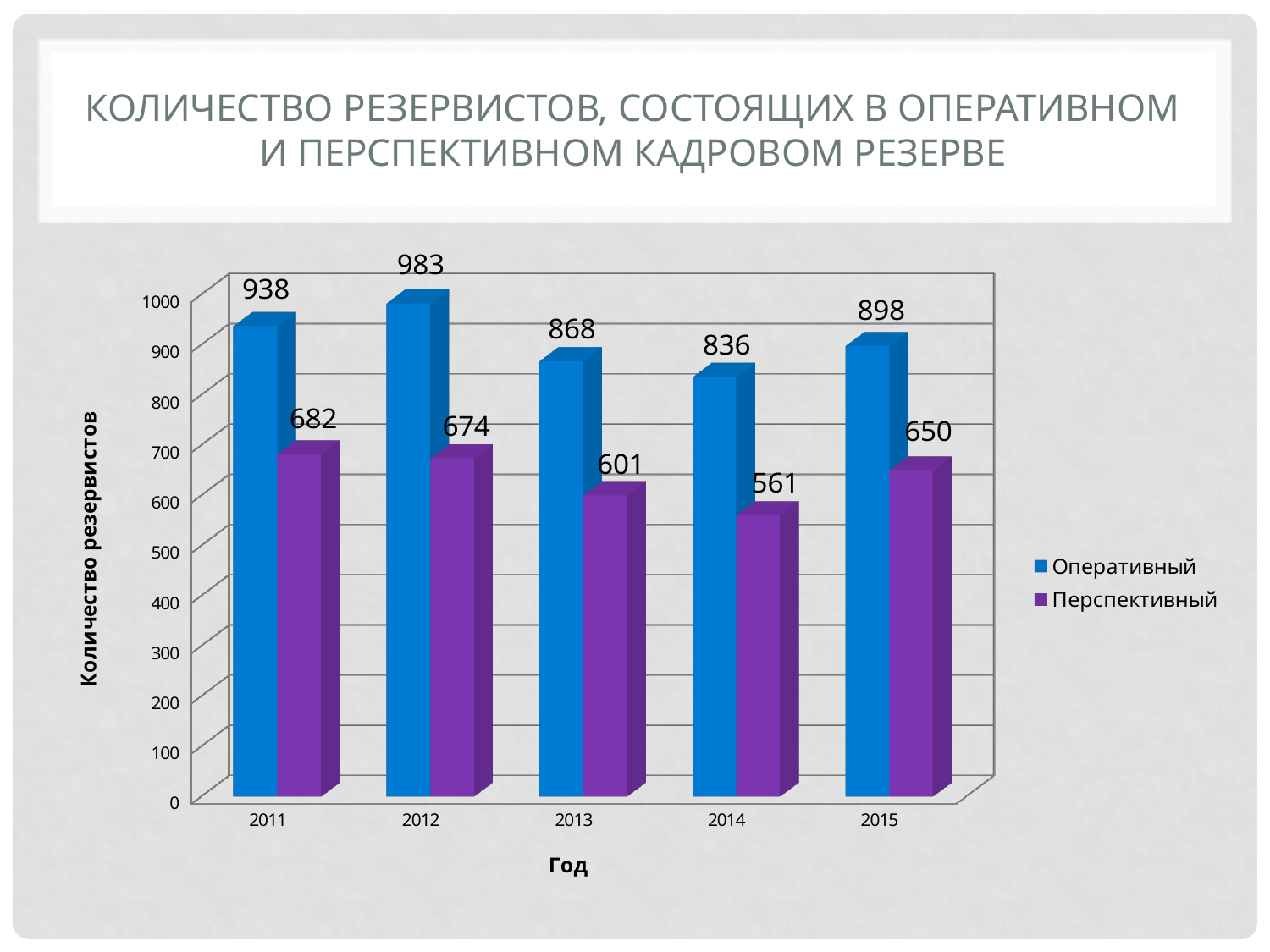
Does the Перспективный series rise or fall from 2011 to 2014? fall Which is larger: the Оперативный value in 2011 or the Оперативный value in 2015? 2011 What is the value for Оперативный in 2012? 983 Which year has the highest value for Оперативный? 2012 How many years are shown on the x axis? 5 What is the label of the y axis? Количество резервистов Which year has the lowest value for Перспективный? 2014 What is the value for Перспективный in 2015? 650 What is the value for Перспективный in 2014? 561 What kind of chart is shown on the slide? bar chart What is the difference between the Оперативный and Перспективный values in 2013? 267 How many series does the legend list? 2